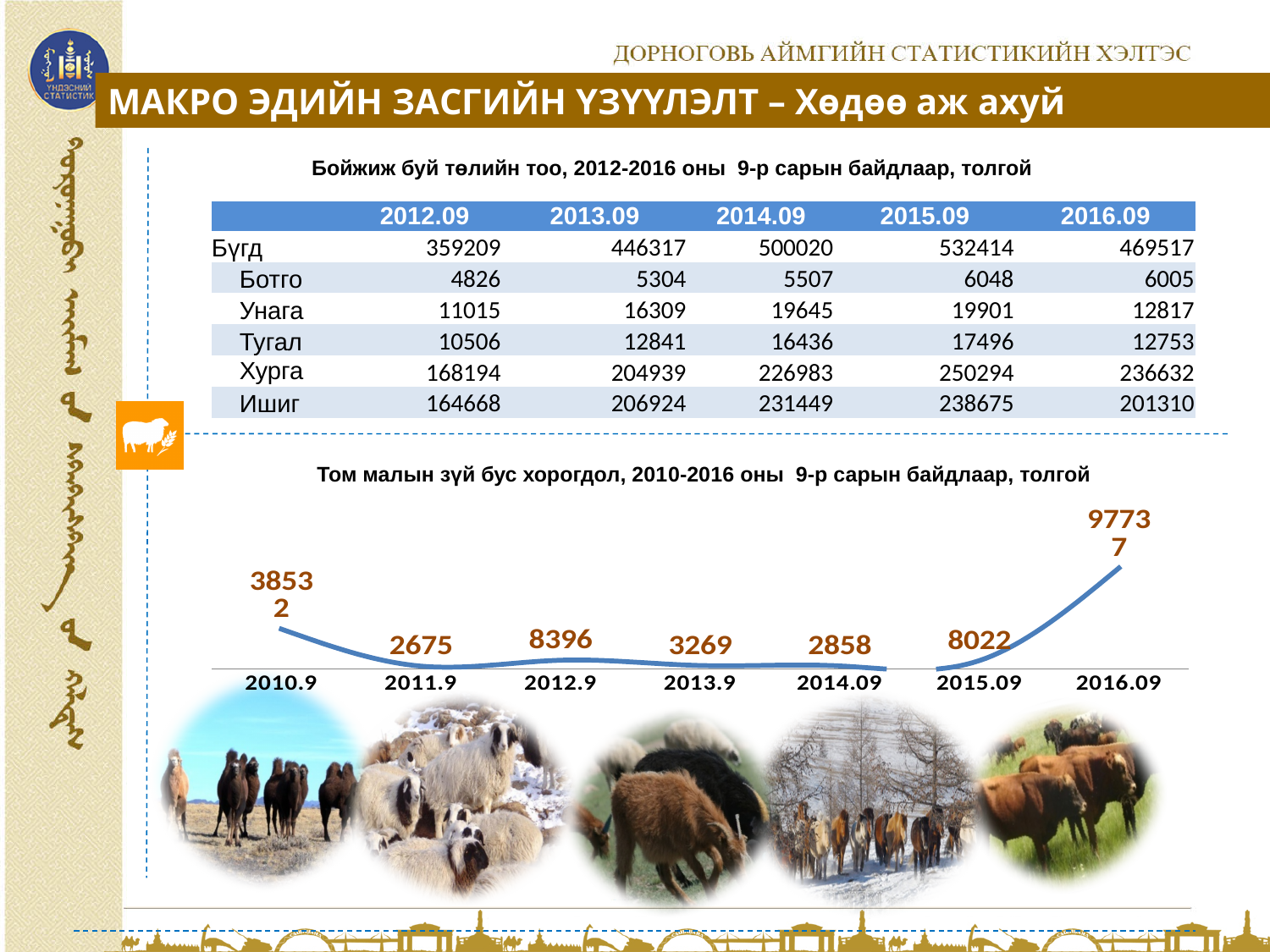
What is the title of the line chart? Том малын зүй бус хорогдол, 2010-2016 оны 9-р сарын байдлаар, толгой What is the difference between the values for 2012.9 and 2013.9 in the line chart? 5127 What is the value for 2015.09 in the line chart? 8022 Which period has the lowest value in the line chart? 2011.9 Which is larger in the line chart, the value for 2012.9 or the value for 2015.09? 2012.9 How many data points are plotted in the line chart? 7 What is the value for 2013.9 in the line chart? 3269 What is the value for 2011.9 in the line chart? 2675 What is the value for 2012.9 in the line chart? 8396 Which period has the highest value in the line chart? 2016.09 What type of chart is shown on the slide? Line chart What is the value for 2014.09 in the line chart? 2858